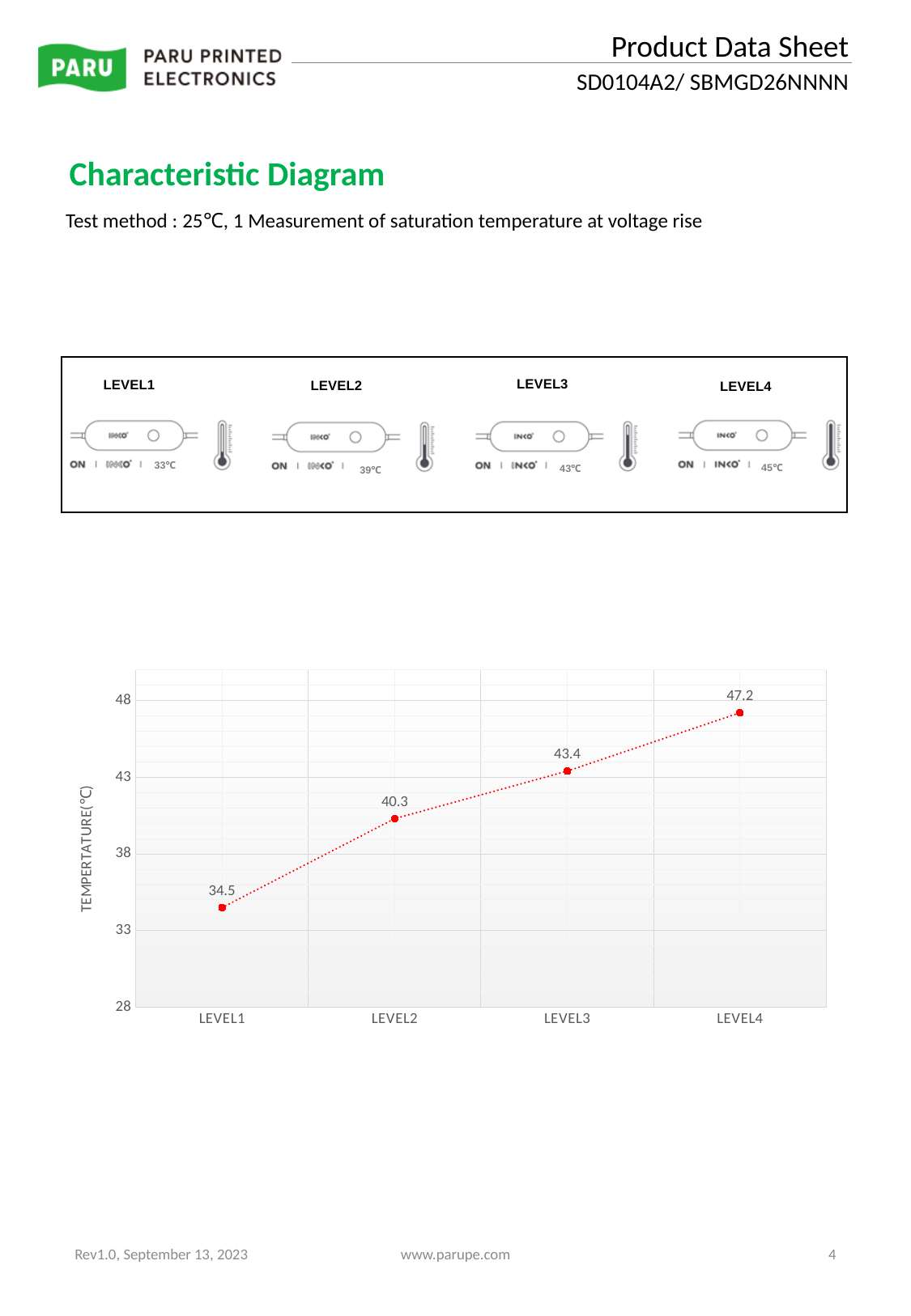
What is the difference between the temperature values for LEVEL2 and LEVEL1? 5.8 Do the plotted temperature values rise or fall from LEVEL1 to LEVEL4? Rise What kind of chart is shown? Line chart What is the difference between the temperature values for LEVEL4 and LEVEL1? 12.7 What is the temperature value plotted for LEVEL3? 43.4 What is the temperature value plotted for LEVEL2? 40.3 Which level has the lowest plotted temperature? LEVEL1 Which has a higher plotted temperature, LEVEL2 or LEVEL3? LEVEL3 Which level has the highest plotted temperature? LEVEL4 How many levels are plotted on the x axis of the chart? 4 What is the temperature value plotted for LEVEL1? 34.5 What is the temperature value plotted for LEVEL4? 47.2